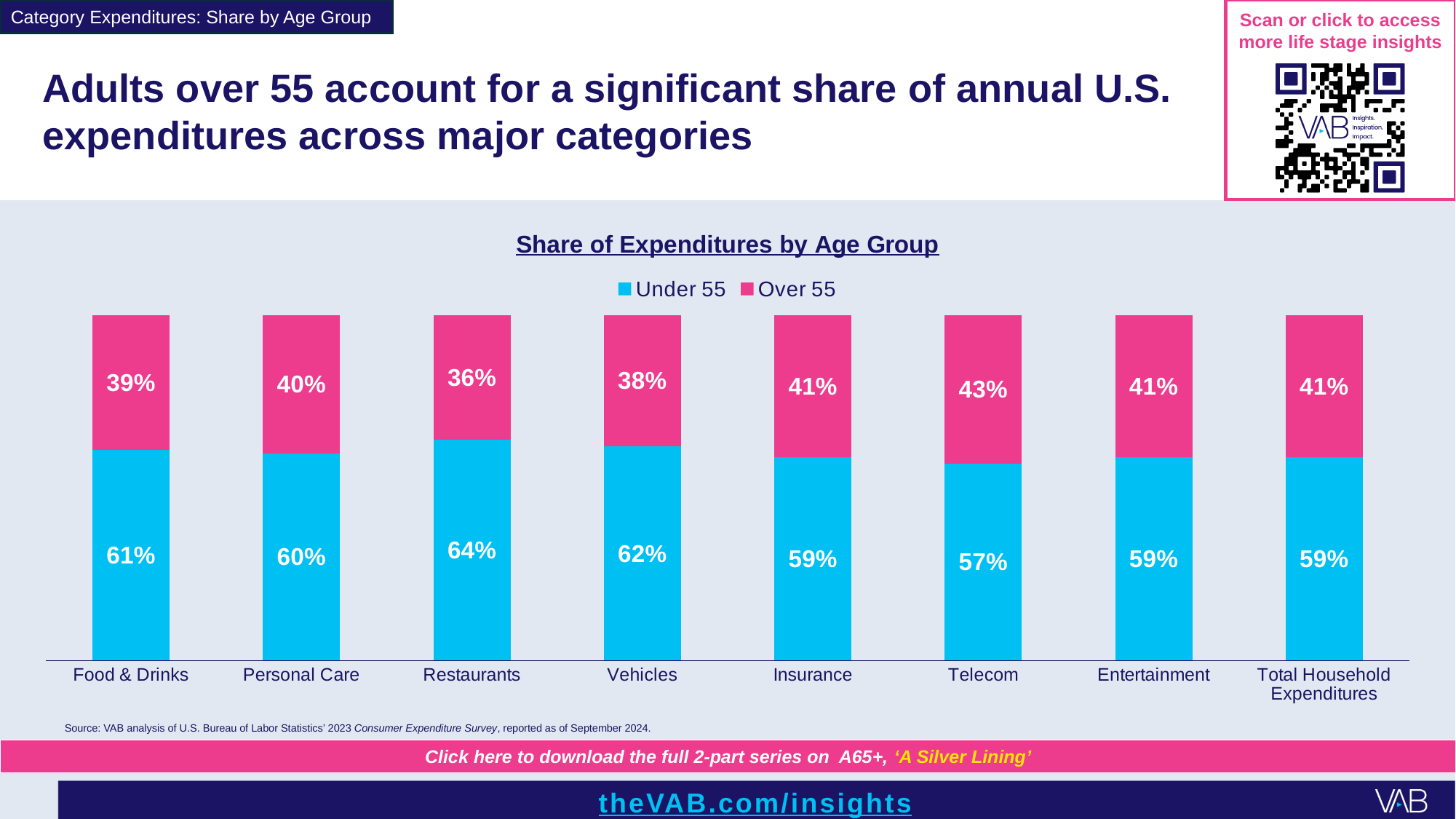
What is the difference between the Under 55 and Over 55 shares for Vehicles? 24% What kind of chart is shown? Stacked bar chart Which category has the highest Over 55 share? Telecom What is the Over 55 share for Total Household Expenditures? 41% Which is larger: the Over 55 share for Personal Care or for Food & Drinks? Personal Care Which category has the lowest Over 55 share? Restaurants Which category has the highest Under 55 share? Restaurants What is the title of the chart? Share of Expenditures by Age Group What is the Over 55 share for Telecom? 43% What is the Under 55 share for Restaurants? 64% How many series does the legend list? 2 How many categories are shown on the x axis? 8